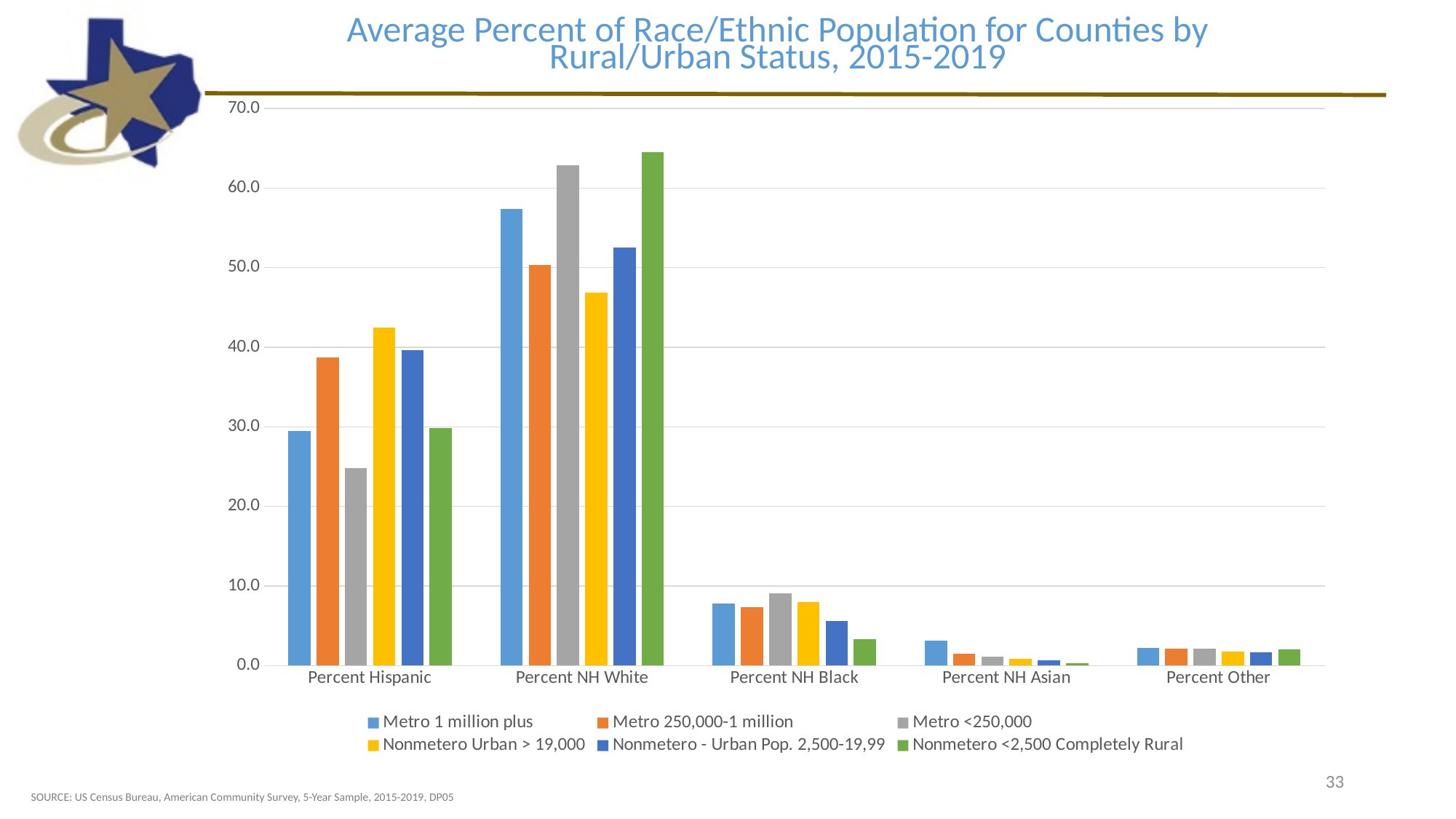
Is the value for Metro <250,000 in the Percent Hispanic category greater or less than 30.0? less Is the value for Metro 1 million plus in the Percent NH White category greater or less than 50.0? greater What kind of chart is shown on the slide? Bar chart Within the Percent Hispanic category, which series has the highest bar? Nonmetero Urban > 19,000 Within the Percent Hispanic category, which series has the lowest bar? Metro <250,000 In the Percent NH Black category, which is larger: Metro <250,000 or Nonmetero <2,500 Completely Rural? Metro <250,000 Within the Percent NH White category, which series has the highest bar? Nonmetero <2,500 Completely Rural Is the value for Nonmetero Urban > 19,000 in the Percent NH White category greater or less than 50.0? less Within the Percent NH Asian category, which series has the highest bar? Metro 1 million plus How many series does the legend list? 6 What is the title of the chart? Average Percent of Race/Ethnic Population for Counties by Rural/Urban Status, 2015-2019 How many race/ethnic categories are shown along the x axis? 5